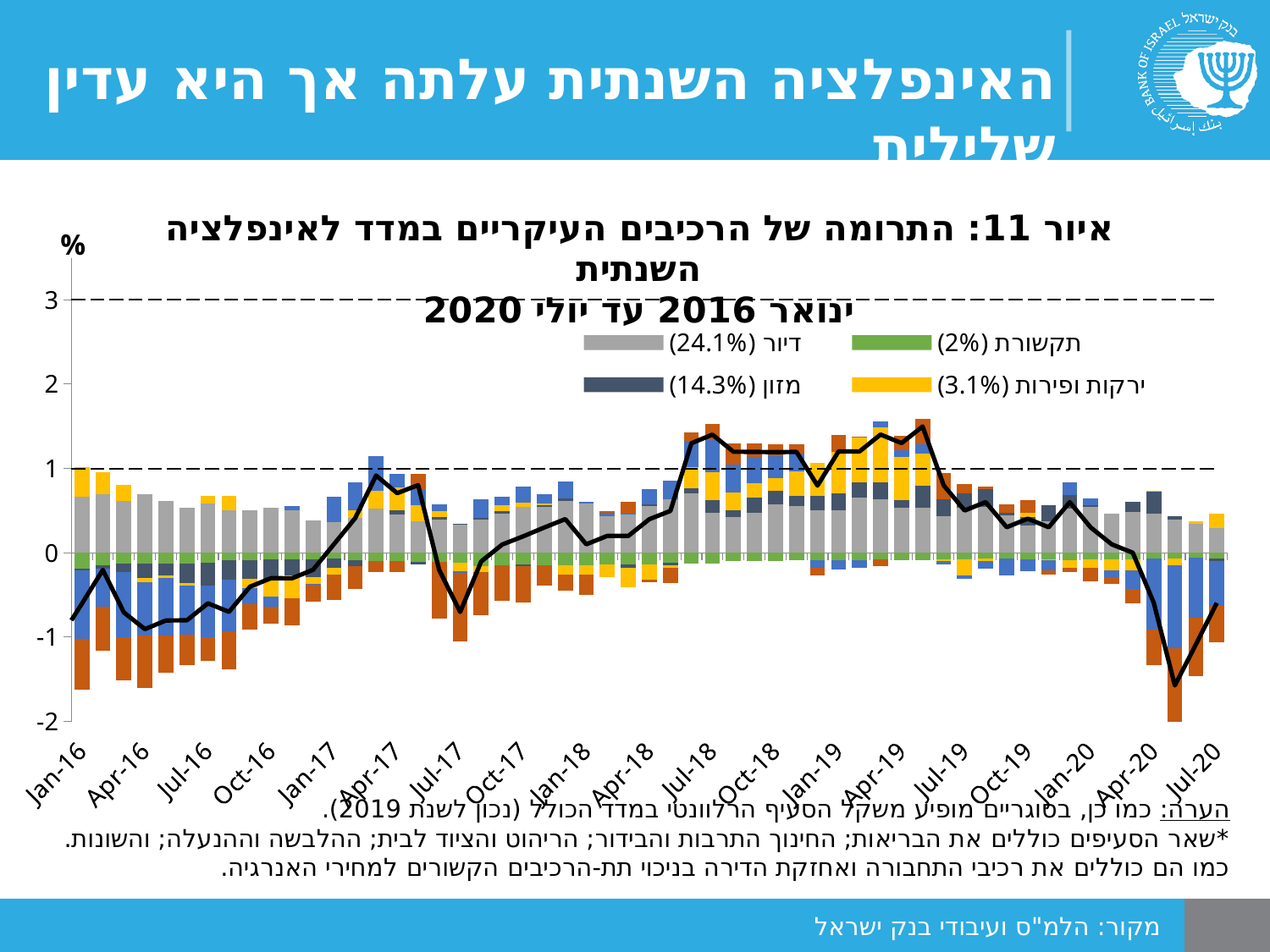
Which colour represents דיור in the legend? Gray Is the value of the line at Jan-16 greater or less than 0? less Is the value of the line at Jul-18 greater or less than 1? greater Which is larger, the line value at Jul-18 or at Jan-16? Jul-18 What kind of chart is shown on the slide? Stacked bar chart with a line overlay How many series does the visible legend list? 4 Is the value of the line at Apr-19 greater or less than 1? greater Does the line rise or fall between Jan-20 and Apr-20? Fall How many month labels are shown on the x axis? 19 What percentage is shown next to מזון in the legend? 14.3%